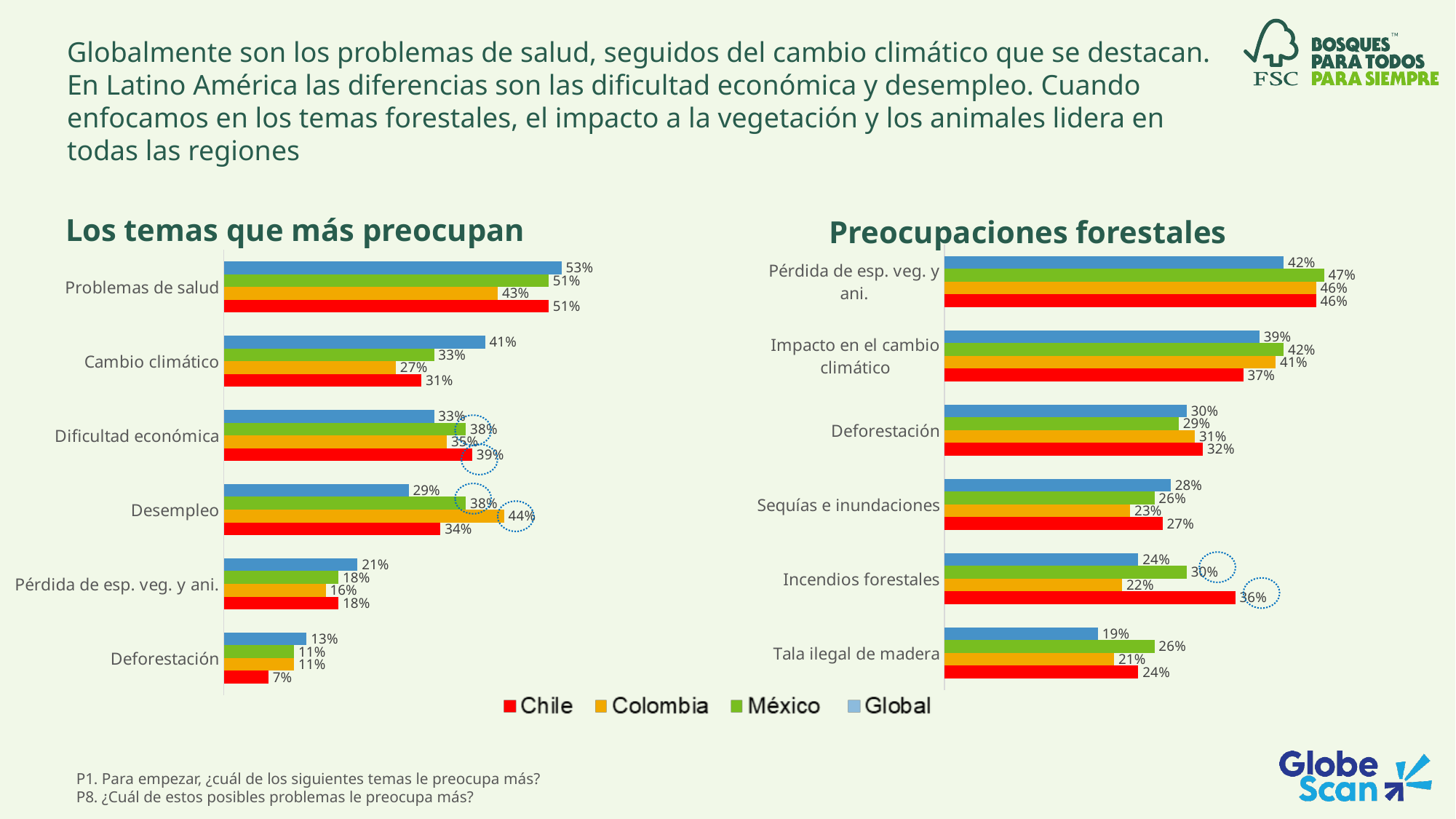
In the chart 'Los temas que más preocupan', which category has the lowest Chile value? Deforestación How many series does the legend list? 4 In the chart 'Preocupaciones forestales', what is the Chile value for Incendios forestales? 36% In the chart 'Preocupaciones forestales', is the Chile value for Incendios forestales larger or smaller than the Colombia value? larger In the chart 'Preocupaciones forestales', what is the México value for Tala ilegal de madera? 26% In the chart 'Los temas que más preocupan', what is the difference between the Global and Chile values for Cambio climático? 10% In the chart 'Los temas que más preocupan', what is the Global value for Problemas de salud? 53% In the chart 'Los temas que más preocupan', what is the Colombia value for Desempleo? 44% In the chart 'Preocupaciones forestales', which category has the highest México value? Pérdida de esp. veg. y ani. In the chart 'Preocupaciones forestales', what is the difference between the Chile and Global values for Incendios forestales? 12% What type of chart is 'Preocupaciones forestales'? Bar chart In the chart 'Los temas que más preocupan', how many categories are shown? 6